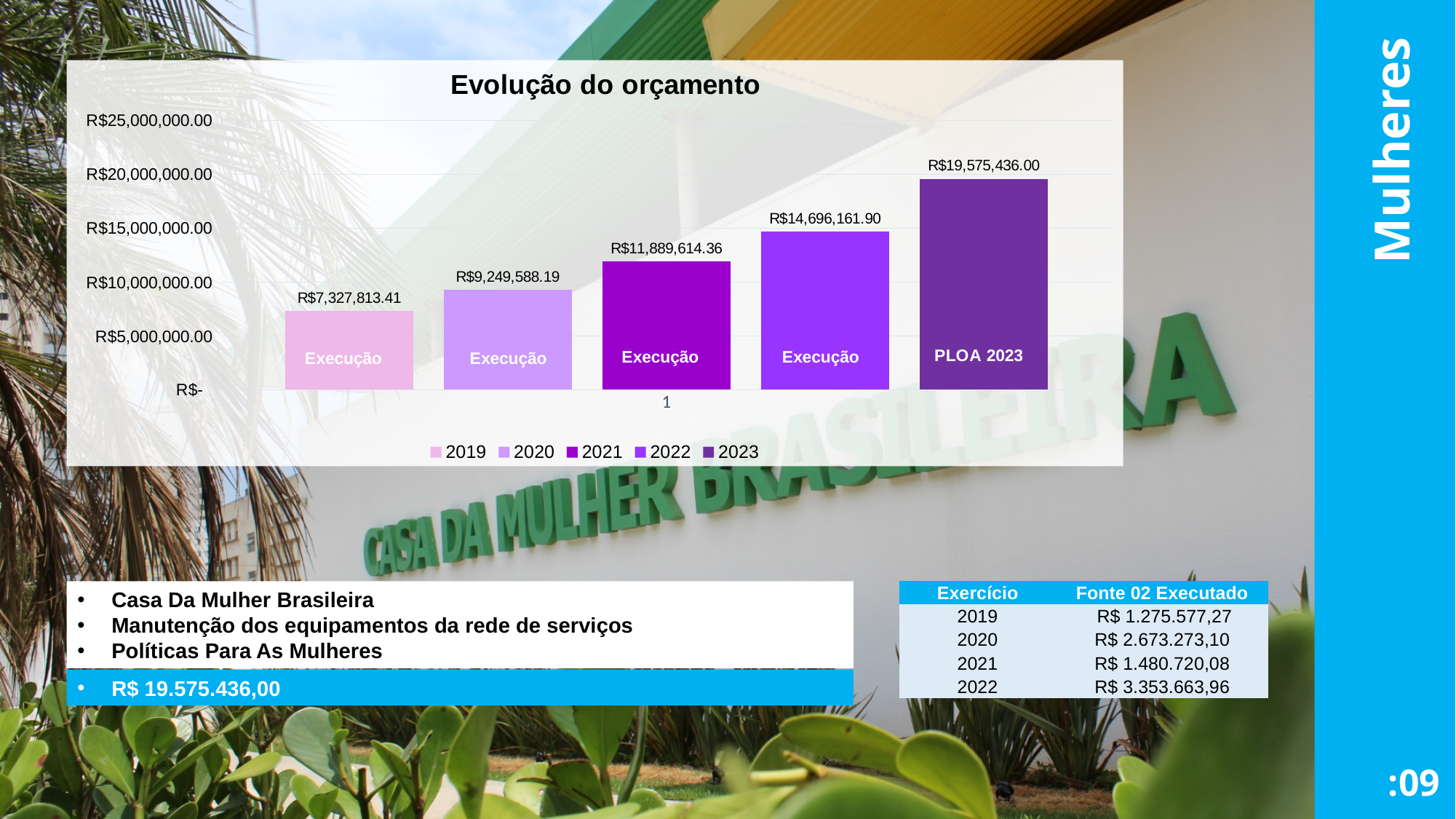
What is the value of the bar labelled PLOA 2023? R$19,575,436.00 What is the title of the chart? Evolução do orçamento Which series has the highest value in the chart? 2023 How many bars are plotted in the chart? 5 Do the values rise or fall from 2019 to 2023 in the chart? rise Which is larger, the 2020 value or the 2022 value? 2022 What type of chart is shown on the slide? bar chart What is the value of the 2019 bar in the chart? R$7,327,813.41 What is the value of the 2021 bar in the chart? R$11,889,614.36 What is the difference between the 2023 value and the 2022 value? R$4,879,274.10 Which series has the lowest value in the chart? 2019 How many series does the chart legend list? 5